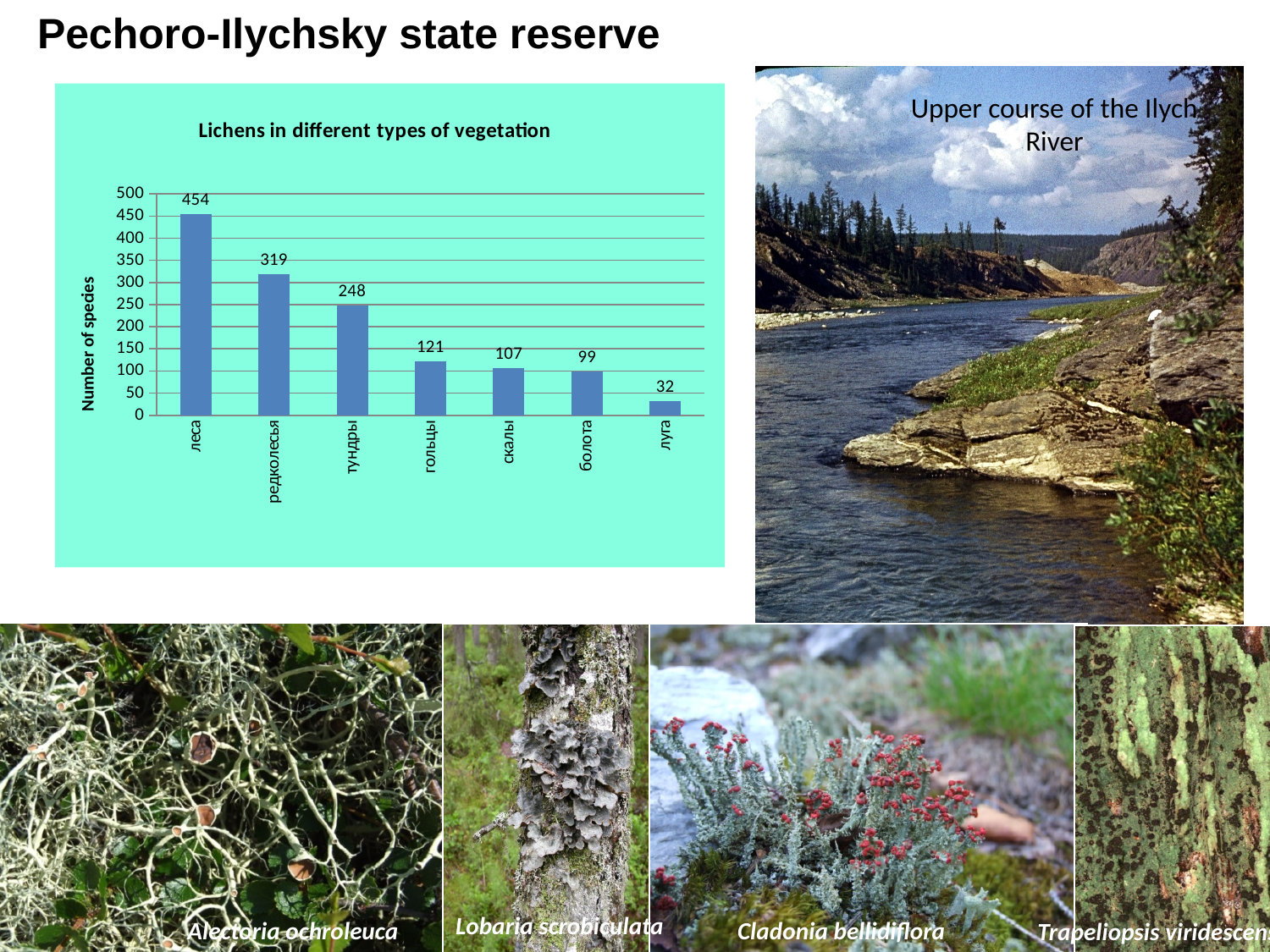
What is the title of the chart? Lichens in different types of vegetation Which vegetation type has the lowest number of lichen species? луга Do the values rise or fall from left to right along the x axis? fall What is the difference in number of species between леса and редколесья? 135 Which vegetation type has the highest number of lichen species? леса How many vegetation types are shown in the chart? 7 Is the value for редколесья greater or less than 300? greater What type of chart is shown on the slide? bar chart What is the number of lichen species for леса? 454 What is the number of lichen species for тундры? 248 What is the number of lichen species for болота? 99 Which has more lichen species, гольцы or скалы? гольцы